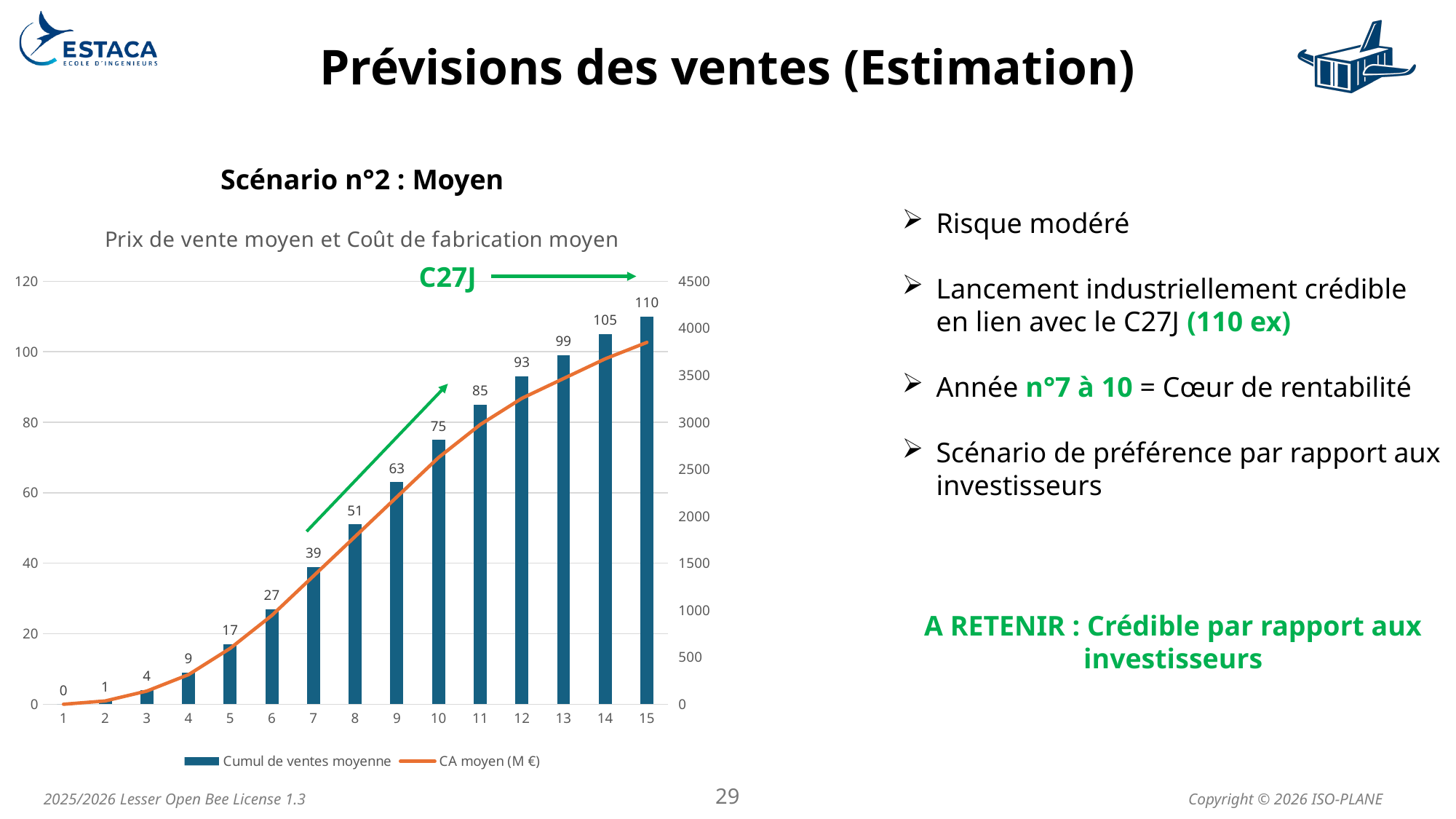
What kind of chart is shown on the slide? Combined bar and line chart Do the 'Cumul de ventes moyenne' values rise or fall from year 1 to year 15? rise Is the 'CA moyen (M €)' value for year 15 greater or less than 3500 on the right-hand axis? greater Which year has the highest 'Cumul de ventes moyenne' value? 15 What is the value of 'Cumul de ventes moyenne' for year 15? 110 Which year has the lowest 'Cumul de ventes moyenne' value? 1 Which is larger, the 'Cumul de ventes moyenne' value for year 8 or for year 12? year 12 How many series does the chart legend list? 2 How many years are shown on the x axis of the chart? 15 What is the value of 'Cumul de ventes moyenne' for year 10? 75 What is the difference between the 'Cumul de ventes moyenne' values for year 15 and year 10? 35 What is the value of 'Cumul de ventes moyenne' for year 7? 39